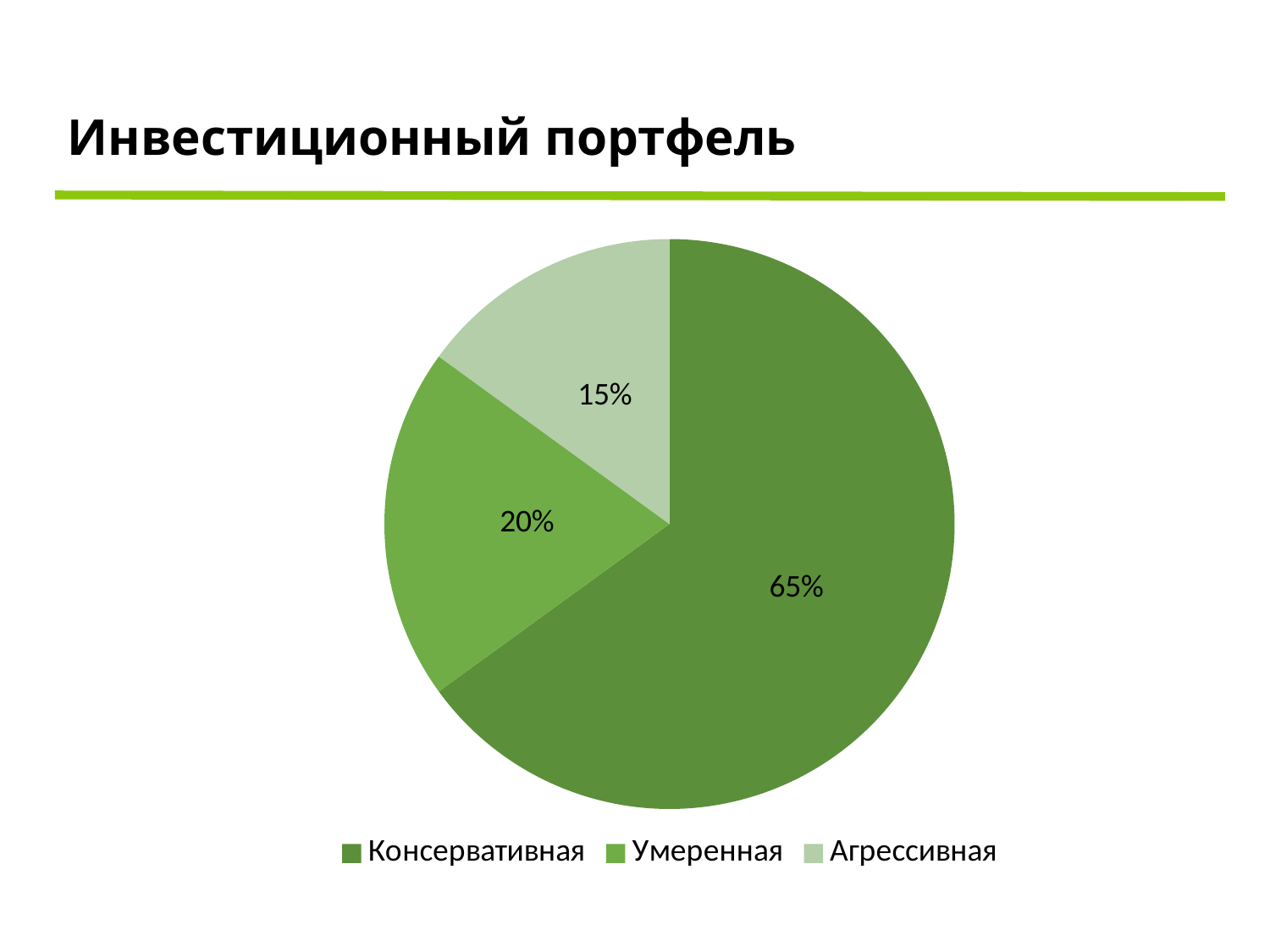
Which category has the largest slice of the pie? Консервативная What is the difference in percentage points between Консервативная and Умеренная? 45 What share of the pie does Консервативная have? 65% What share of the pie does Агрессивная have? 15% Which is larger, the share for Умеренная or the share for Агрессивная? Умеренная What share of the pie does Умеренная have? 20% How many categories are shown in the pie chart? 3 Which category has the smallest slice of the pie? Агрессивная Which legend entry is shown with the lightest green colour? Агрессивная What is the title of the slide? Инвестиционный портфель What kind of chart is shown on the slide? Pie chart What is the difference in percentage points between Умеренная and Агрессивная? 5